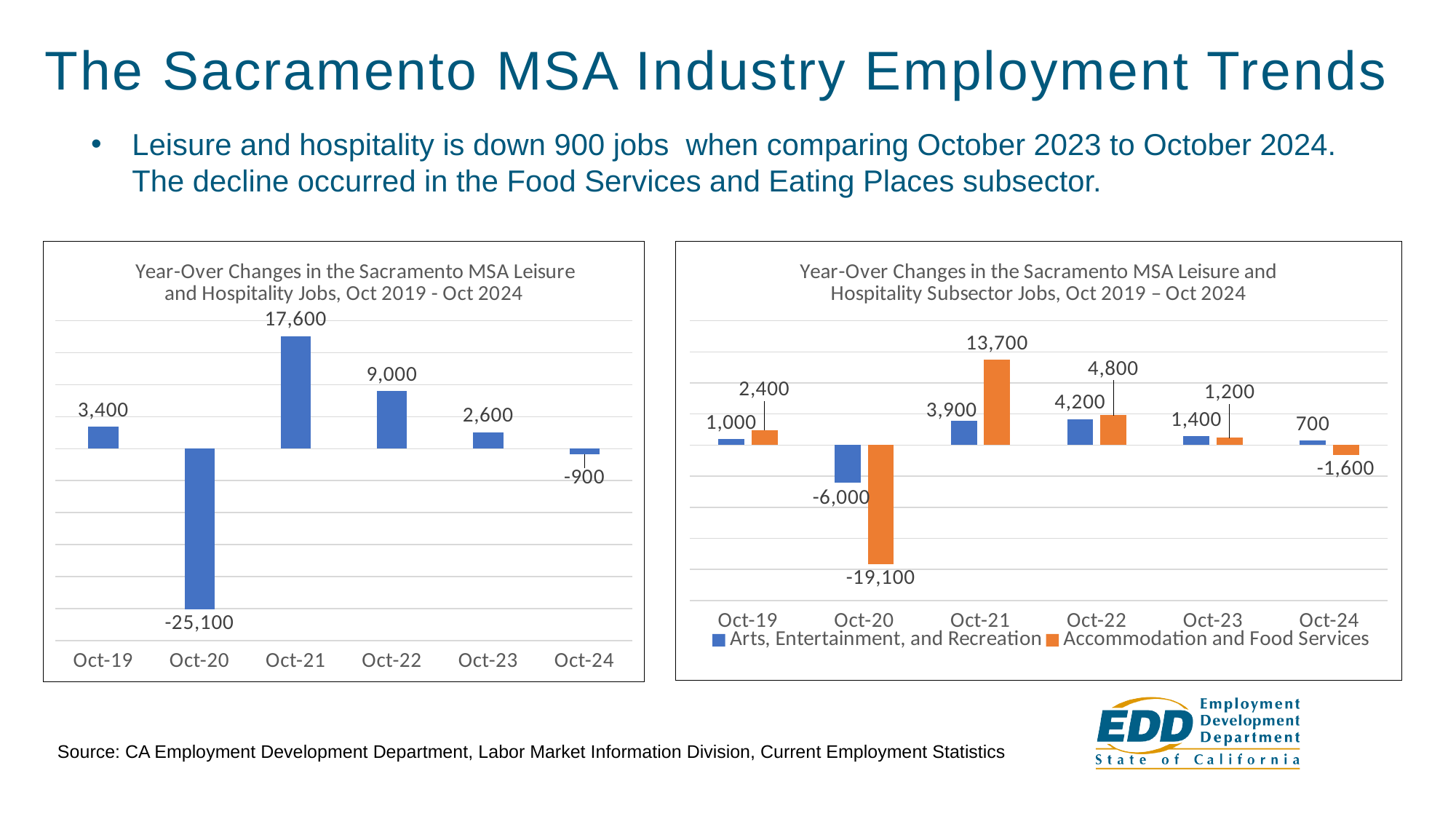
In the right chart (Year-Over Changes in the Sacramento MSA Leisure and Hospitality Subsector Jobs), which series has the larger value in Oct-23? Arts, Entertainment, and Recreation In the left chart (Year-Over Changes in the Sacramento MSA Leisure and Hospitality Jobs), which period has the lowest value? Oct-20 What kind of chart is the left chart (Year-Over Changes in the Sacramento MSA Leisure and Hospitality Jobs)? Bar chart In the right chart (Year-Over Changes in the Sacramento MSA Leisure and Hospitality Subsector Jobs), what is the value for Arts, Entertainment, and Recreation in Oct-22? 4,200 In the left chart (Year-Over Changes in the Sacramento MSA Leisure and Hospitality Jobs), what is the value for Oct-21? 17,600 In the left chart (Year-Over Changes in the Sacramento MSA Leisure and Hospitality Jobs), what is the difference between the Oct-21 and Oct-22 values? 8,600 How many series does the legend of the right chart (Year-Over Changes in the Sacramento MSA Leisure and Hospitality Subsector Jobs) list? 2 In the right chart (Year-Over Changes in the Sacramento MSA Leisure and Hospitality Subsector Jobs), which period has the highest value for Accommodation and Food Services? Oct-21 In the right chart (Year-Over Changes in the Sacramento MSA Leisure and Hospitality Subsector Jobs), what is the difference between the Accommodation and Food Services and Arts, Entertainment, and Recreation values in Oct-21? 9,800 In the left chart (Year-Over Changes in the Sacramento MSA Leisure and Hospitality Jobs), what is the value for Oct-24? -900 In the left chart (Year-Over Changes in the Sacramento MSA Leisure and Hospitality Jobs), how many periods are shown on the x axis? 6 In the right chart (Year-Over Changes in the Sacramento MSA Leisure and Hospitality Subsector Jobs), what is the value for Accommodation and Food Services in Oct-20? -19,100